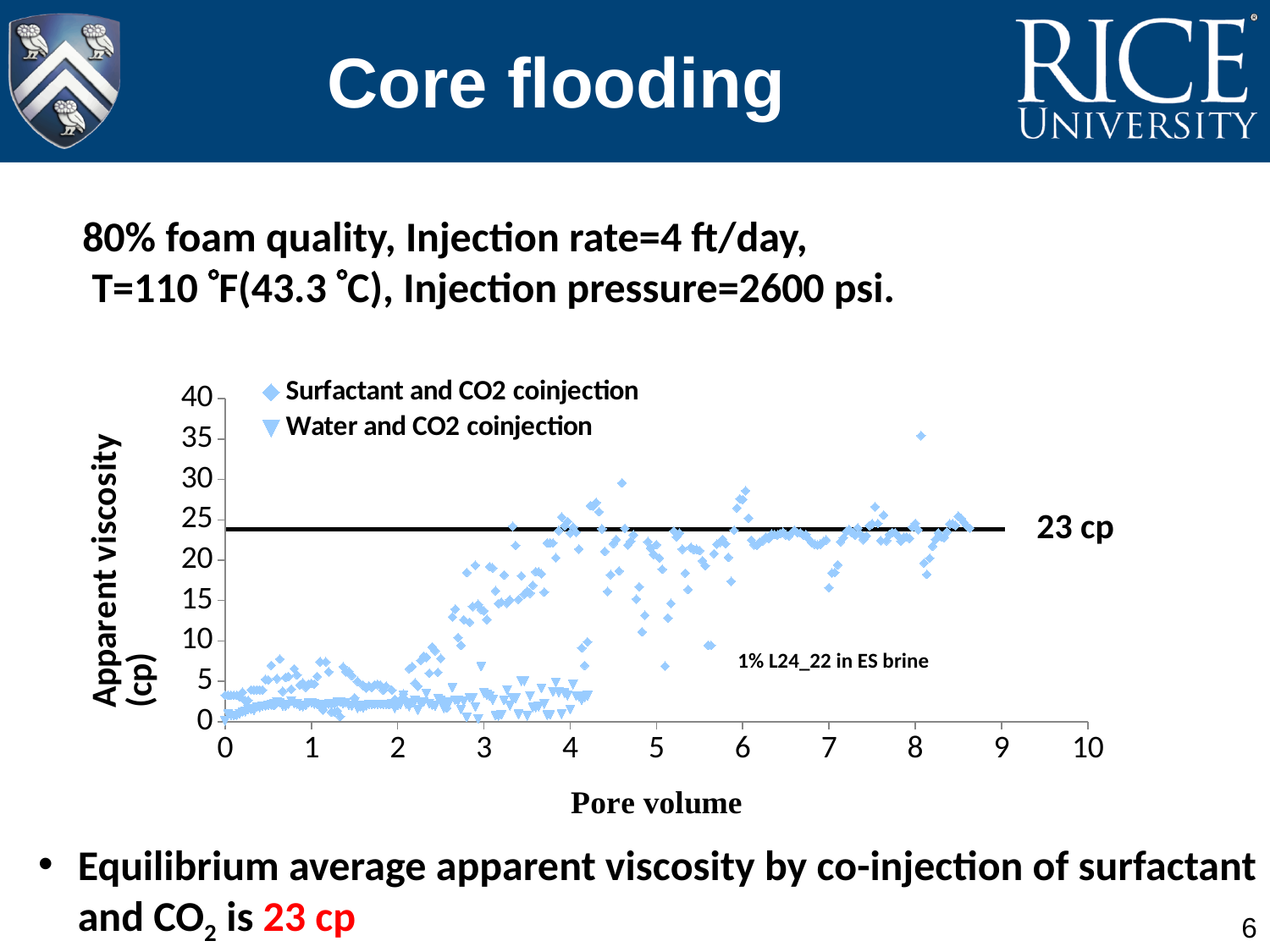
Which series reaches higher apparent viscosity values, Surfactant and CO2 coinjection or Water and CO2 coinjection? Surfactant and CO2 coinjection What is the highest value shown on the chart's x axis? 10 What kind of chart is shown on the slide? Scatter chart Are the Water and CO2 coinjection values at pore volume 3 greater or less than 10? less Do the Surfactant and CO2 coinjection values rise or fall as pore volume increases from 0 to 4? Rise Is the highest Surfactant and CO2 coinjection point on the chart greater or less than 30? greater What value is the horizontal reference line in the chart labelled with? 23 cp What is the label on the chart's x axis? Pore volume Are the Surfactant and CO2 coinjection values at pore volume 8 greater or less than 15? greater What are the two series named in the chart legend? Surfactant and CO2 coinjection; Water and CO2 coinjection How many series does the chart legend list? 2 What is the highest value shown on the chart's y axis? 40